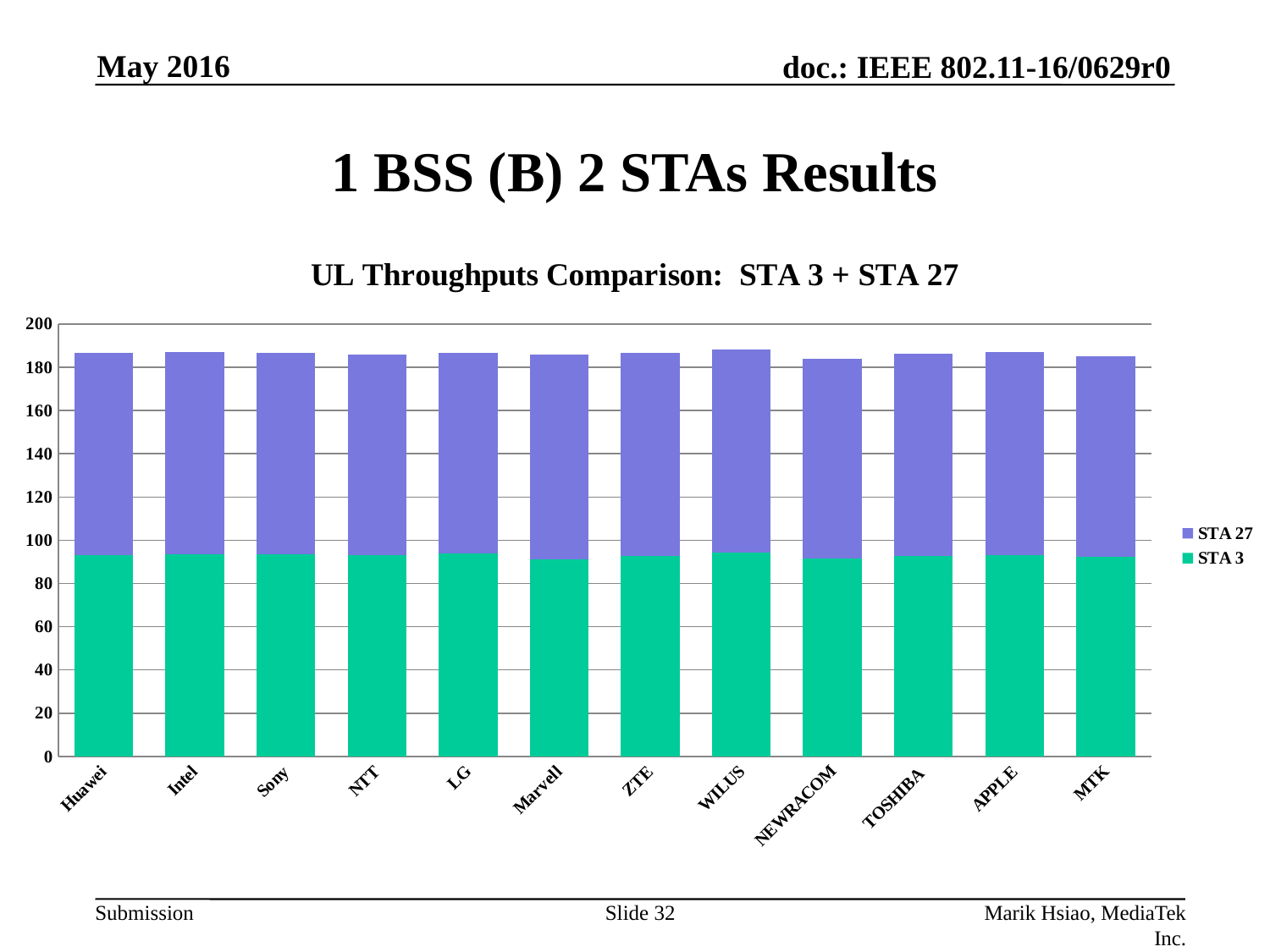
Is the STA 3 value for Intel greater or less than 80? greater Is the total stacked value for WILUS greater or less than 140? greater Is the STA 3 value for Huawei greater or less than 100? less What is the title of the chart? UL Throughputs Comparison: STA 3 + STA 27 How many series does the legend list? 2 Which series forms the bottom segment of each stacked bar? STA 3 What kind of chart is shown on the slide? bar chart How many categories are shown along the x axis? 12